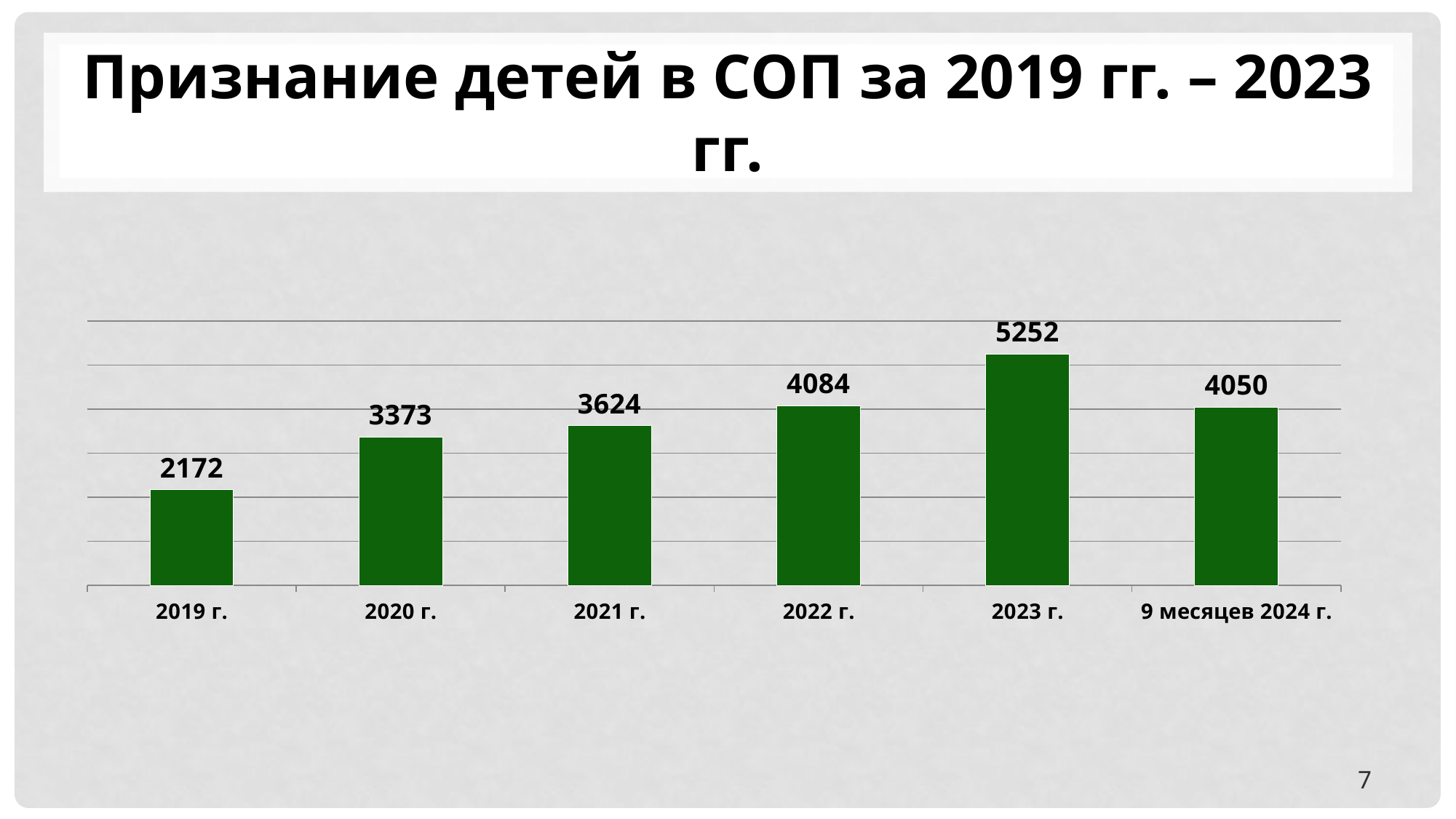
What is the difference between the values for 2023 г. and 2022 г.? 1168 Which category has the highest value? 2023 г. What kind of chart is shown on the slide? bar chart What colour are the bars in the chart? green What is the value for 9 месяцев 2024 г.? 4050 What is the difference between the values for 2020 г. and 2019 г.? 1201 How many categories are shown on the x axis? 6 Which is larger, the value for 2022 г. or the value for 9 месяцев 2024 г.? 2022 г. Do the values rise or fall from 2019 г. to 2023 г.? rise Which category has the lowest value? 2019 г. What is the value for 2019 г.? 2172 What is the value for 2021 г.? 3624